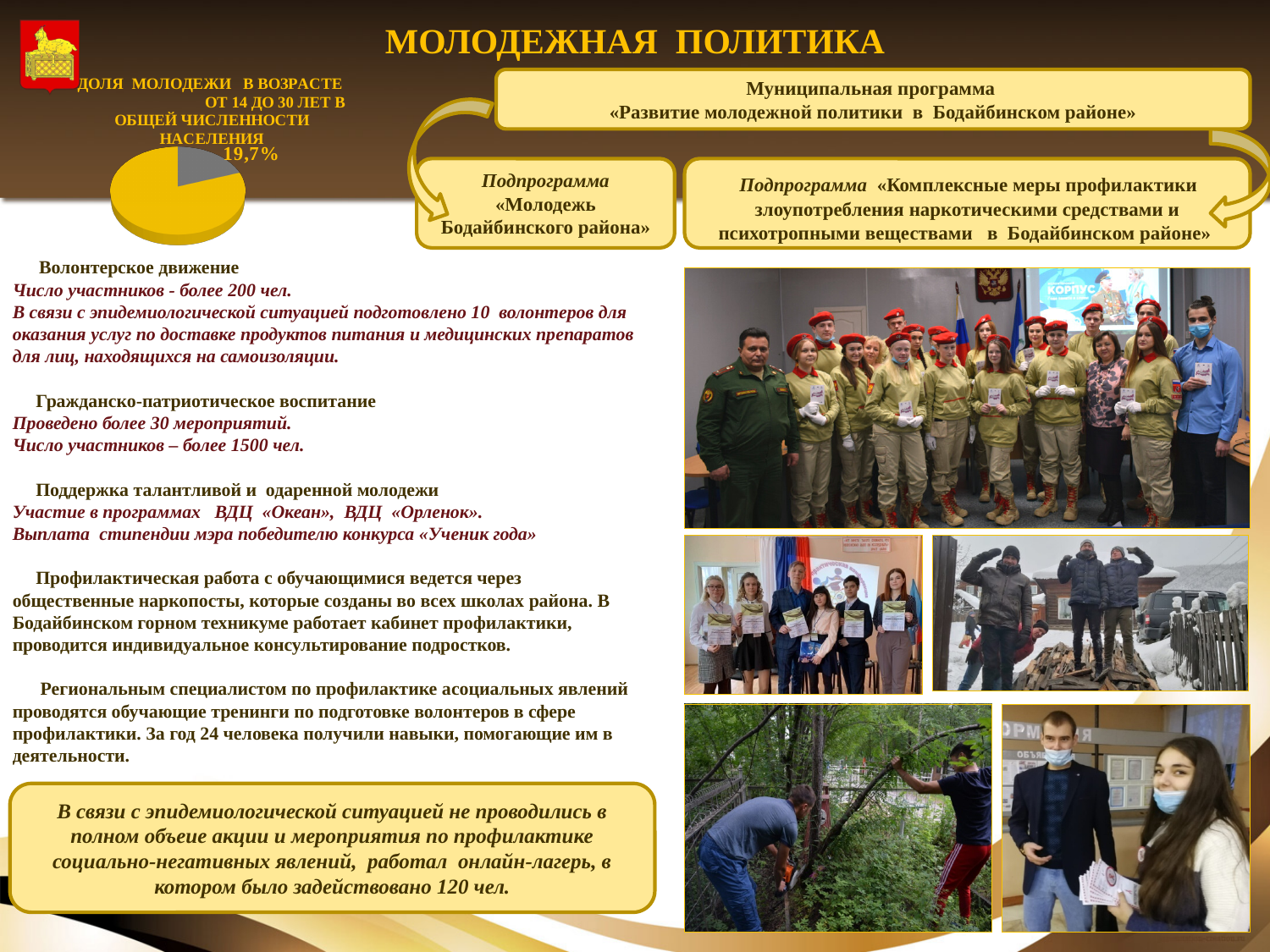
Which slice of the pie chart is larger, the yellow one or the grey one? the yellow one What share of the total population do young people aged 14 to 30 make up, according to the pie chart? 19,7% Is the share of youth aged 14 to 30 shown in the pie chart greater or less than 50%? less What colour is the slice labelled 19,7% in the pie chart? grey What is the title of the pie chart on the slide? ДОЛЯ МОЛОДЕЖИ В ВОЗРАСТЕ ОТ 14 ДО 30 ЛЕТ В ОБЩЕЙ ЧИСЛЕННОСТИ НАСЕЛЕНИЯ How many slices does the pie chart have? 2 What type of chart is shown on the slide? pie chart What percentage value is labelled on the pie chart? 19,7%